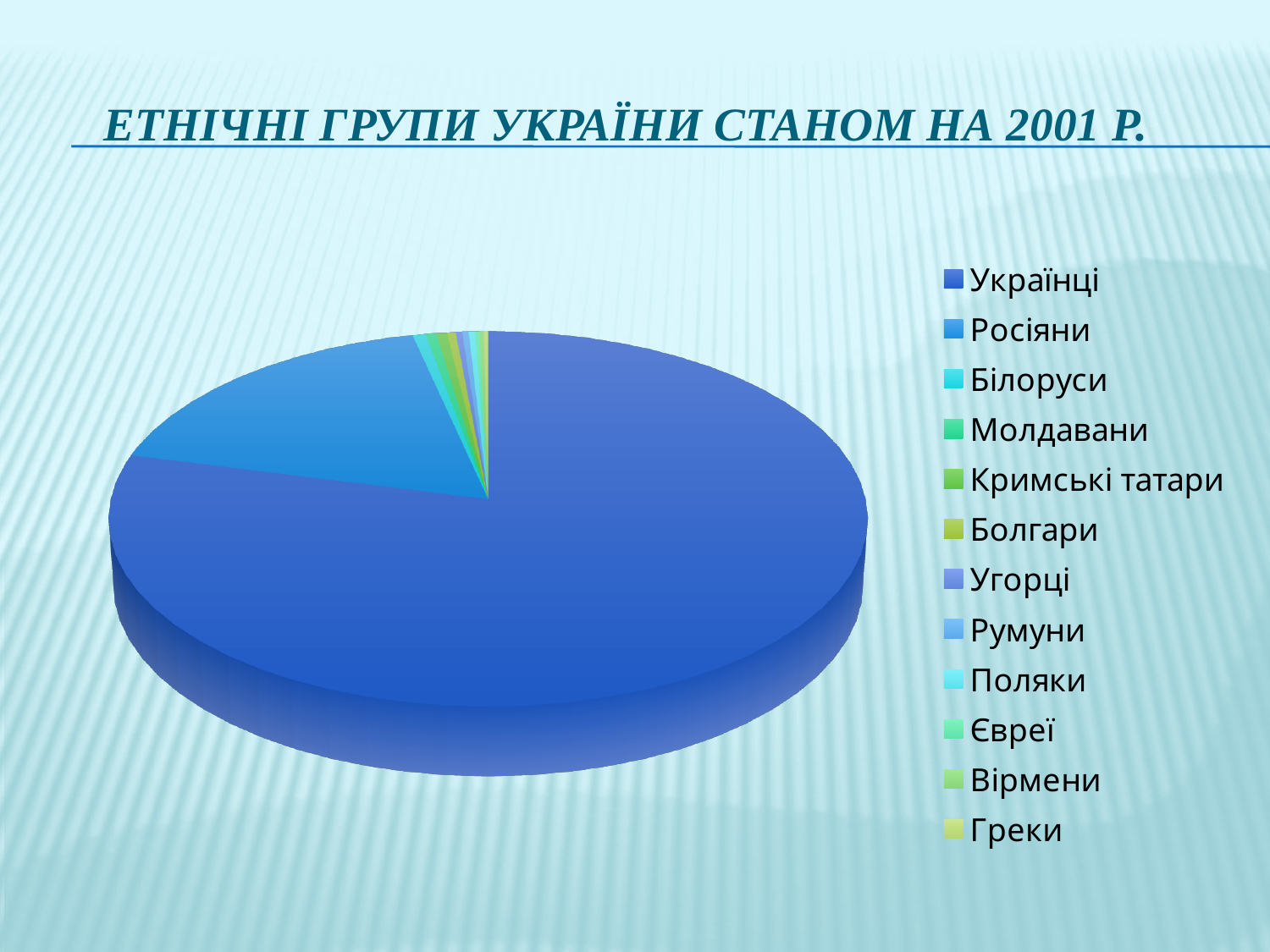
Which slice is larger, Росіяни or Молдавани? Росіяни Which slice is larger, Росіяни or Білоруси? Росіяни Which ethnic group has the largest slice of the pie? Українці Which slice is larger, Українці or Росіяни? Українці Which ethnic group is listed first in the legend? Українці Which ethnic group has the second largest slice of the pie? Росіяни What kind of chart is shown on the slide? Pie chart What is the title of the chart on the slide? ЕТНІЧНІ ГРУПИ УКРАЇНИ СТАНОМ НА 2001 Р. How many ethnic groups are listed in the chart's legend? 12